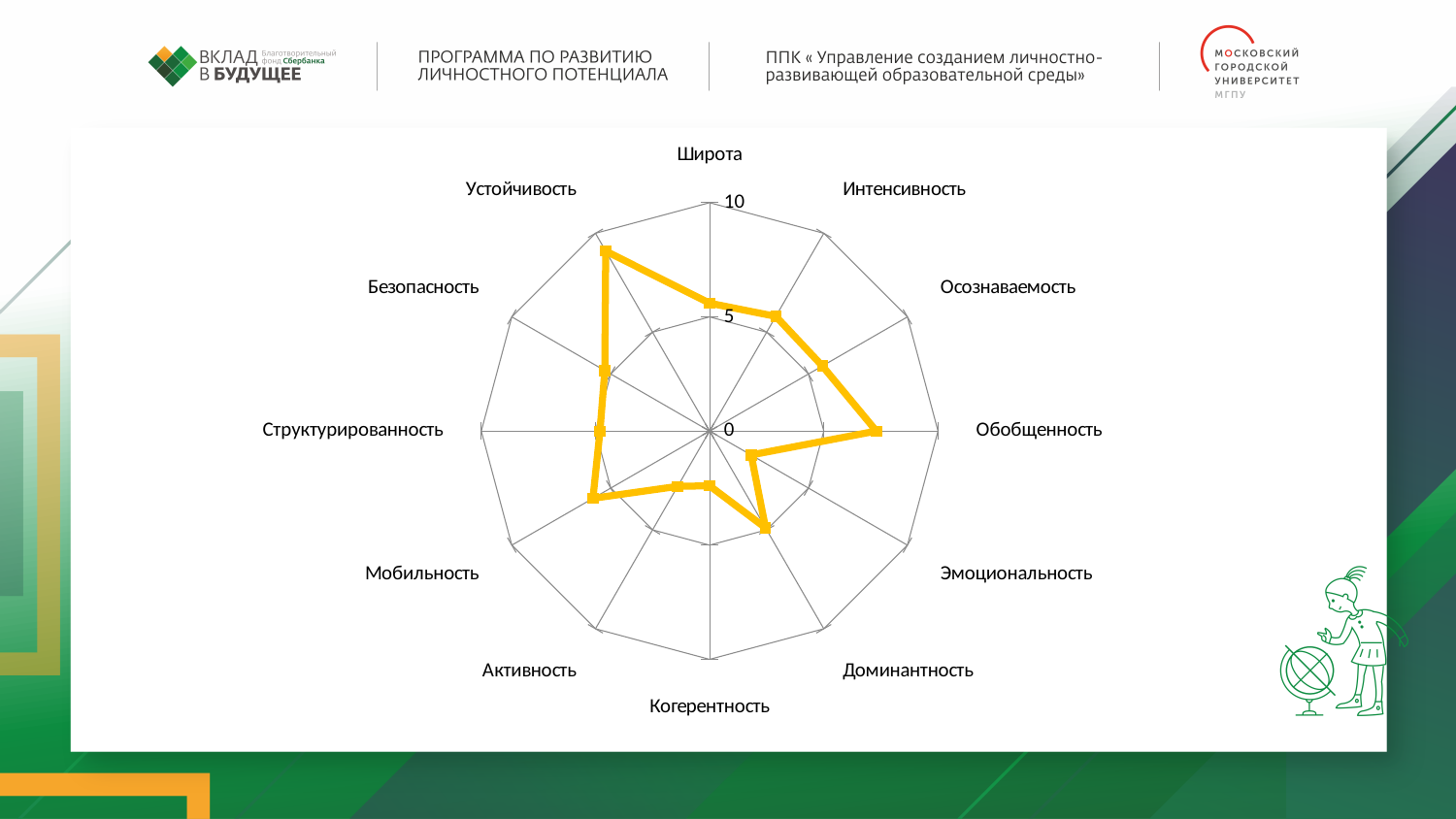
What colour is the data line on the radar chart? yellow How many categories (axes) does the radar chart have? 12 Which is larger, the value for Устойчивость or the value for Осознаваемость? Устойчивость Is the value for Эмоциональность greater or less than 5? less Is the value for Когерентность greater or less than 5? less What kind of chart is shown on the slide? radar chart What is the maximum value shown on the radar chart's axis scale? 10 Is the value for Обобщенность greater or less than 5? greater Which is larger, the value for Обобщенность or the value for Когерентность? Обобщенность Which is larger, the value for Устойчивость or the value for Эмоциональность? Устойчивость Which category has the highest value on the radar chart? Устойчивость